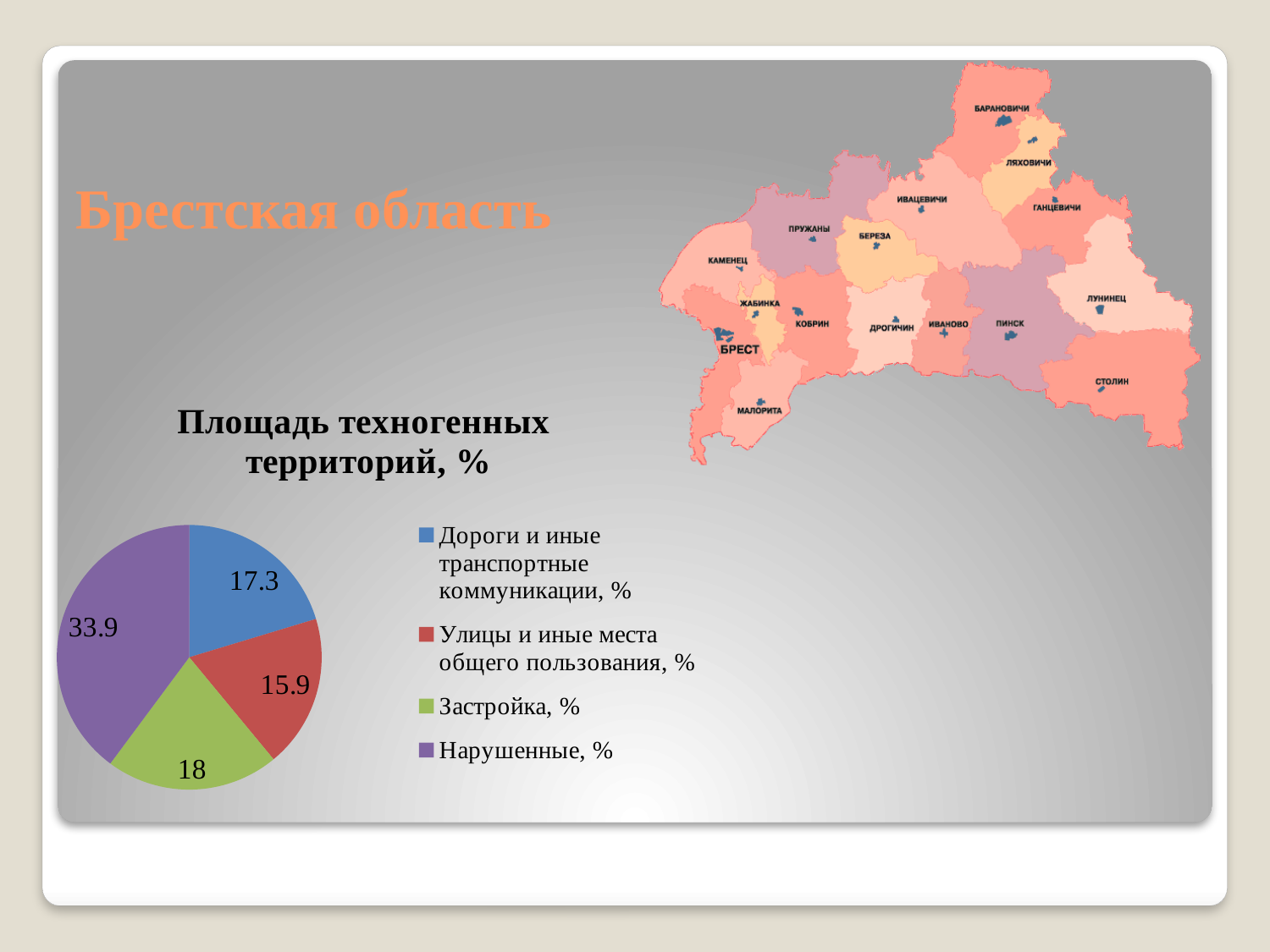
Which is larger: the value for Дороги и иные транспортные коммуникации, % or the value for Улицы и иные места общего пользования, %? Дороги и иные транспортные коммуникации, % What is the value for Застройка, %? 18 Which category has the smallest slice of the pie? Улицы и иные места общего пользования, % What colour is the slice for Застройка, %? Green What is the value for Улицы и иные места общего пользования, %? 15.9 What is the value for Нарушенные, %? 33.9 How many categories does the pie chart have? 4 Which category has the largest slice of the pie? Нарушенные, % What is the value for Дороги и иные транспортные коммуникации, %? 17.3 What is the title of the chart on the slide? Площадь техногенных территорий, % What type of chart is shown on the slide? Pie chart What is the difference between the values for Нарушенные, % and Застройка, %? 15.9